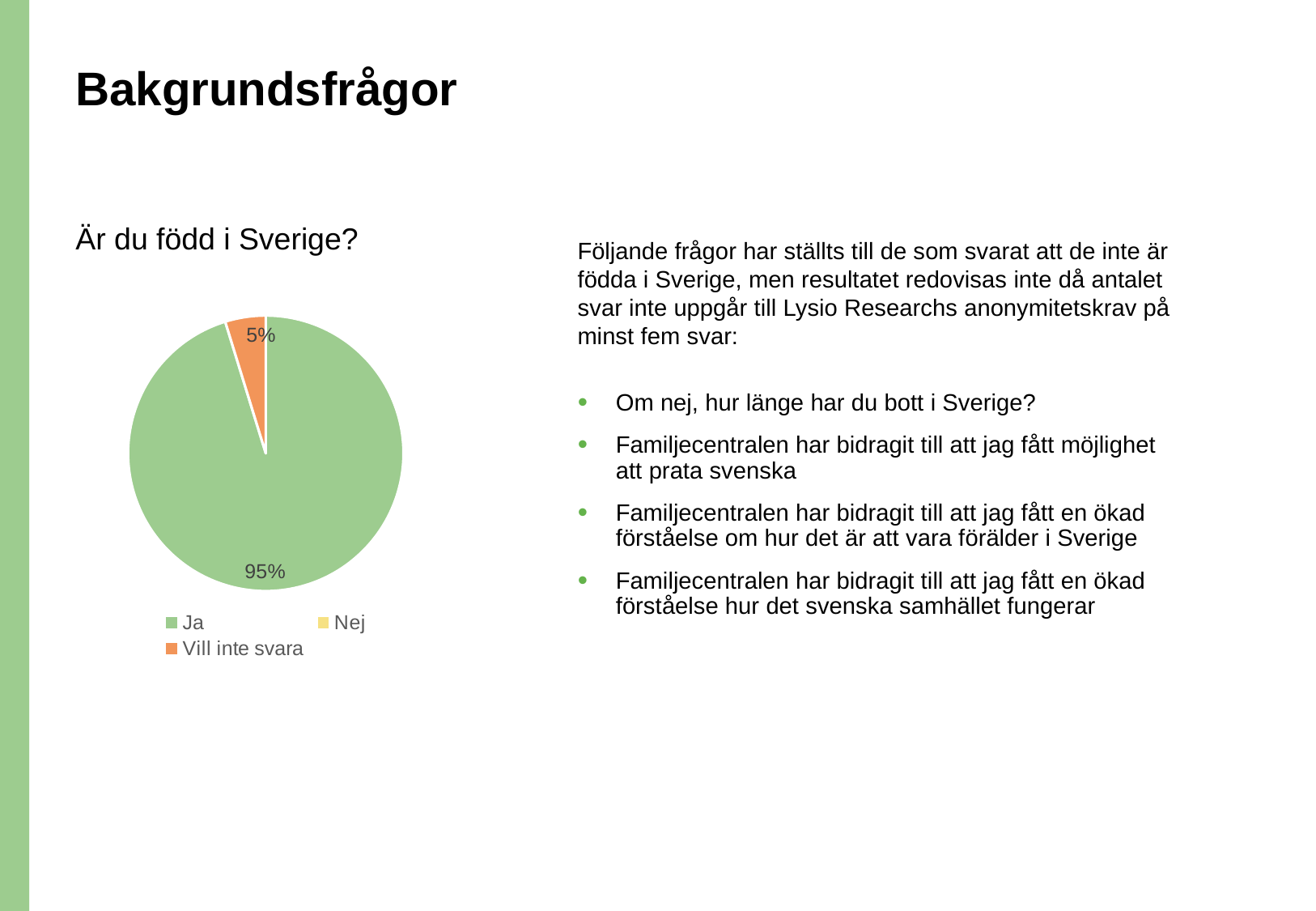
Which of the two labelled slices is larger, "Ja" or "Vill inte svara"? Ja What is the difference in percentage points between the "Ja" slice and the "Vill inte svara" slice? 90 What colour is the "Ja" slice in the pie chart? green What is the title of the pie chart? Är du född i Sverige? How many entries does the legend of the pie chart list? 3 What share of the pie is labelled for "Ja"? 95% What kind of chart is shown under "Är du född i Sverige?"? pie chart Which category has the largest slice of the pie? Ja Is the share for "Ja" greater or less than 50%? greater What share of the pie is labelled for "Vill inte svara"? 5% Is the share for "Vill inte svara" greater or less than 10%? less